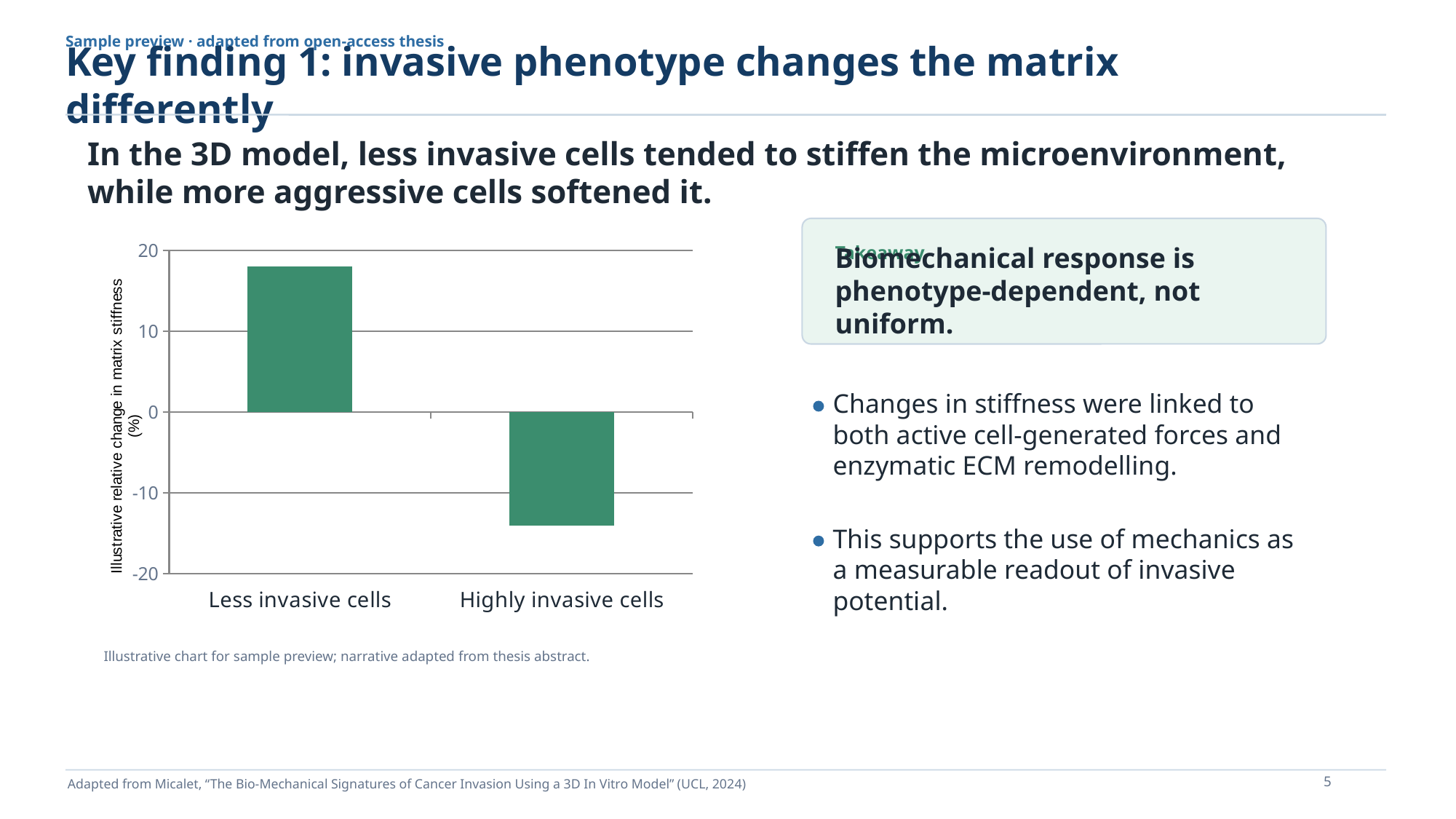
What is the lowest tick value shown on the vertical axis? -20 Is the value for Highly invasive cells greater or less than -10? less Is the value for Highly invasive cells greater or less than 0? less Do the values rise or fall moving from left to right along the x axis? fall Which category has the highest value in the chart? Less invasive cells Which is larger, the value for Less invasive cells or the value for Highly invasive cells? Less invasive cells Which category has the lowest value in the chart? Highly invasive cells What kind of chart is shown on the slide? bar chart Is the value for Less invasive cells greater or less than 10? greater What is the label on the vertical axis of the chart? Illustrative relative change in matrix stiffness (%) How many categories are plotted on the x axis of the chart? 2